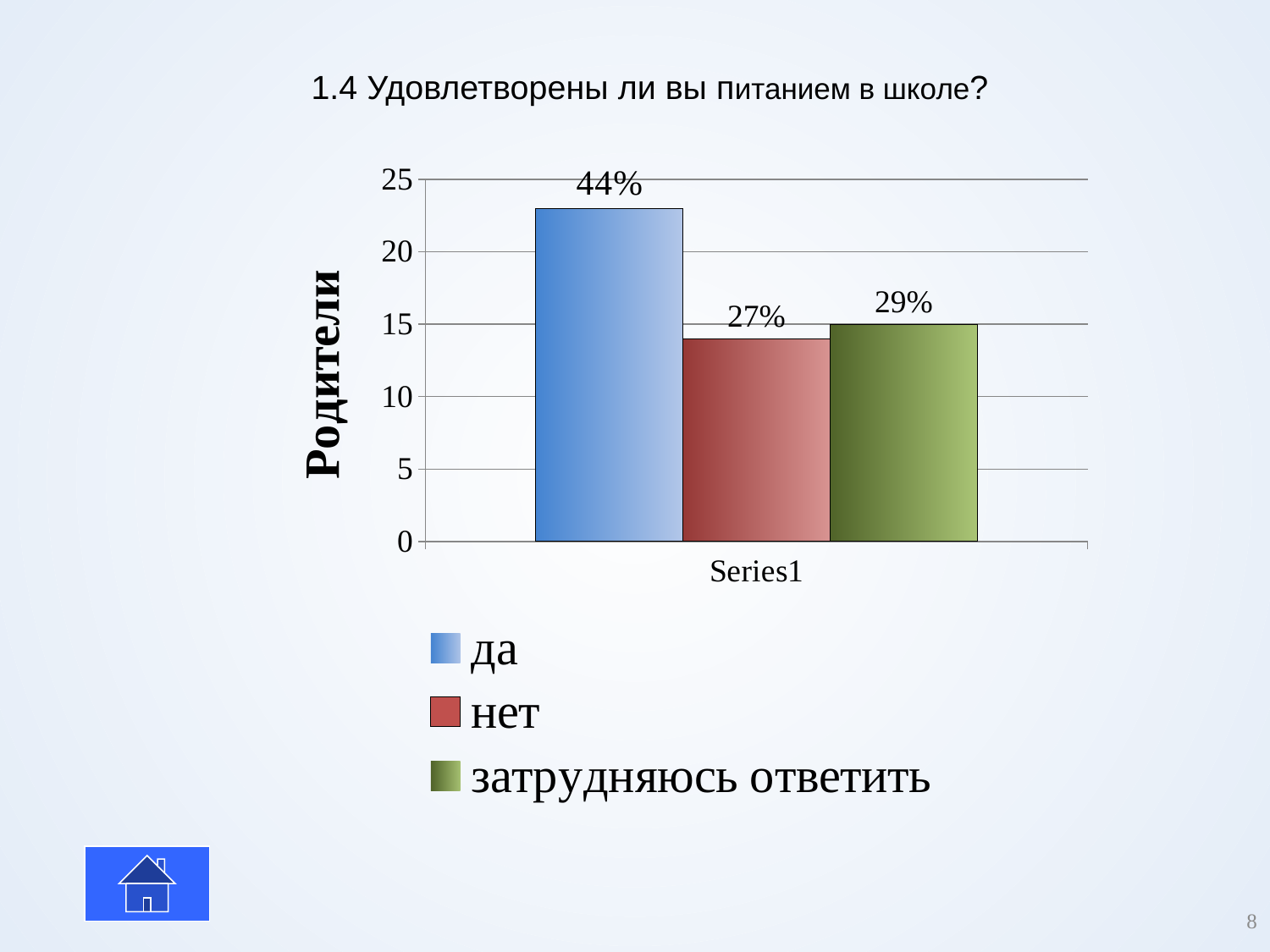
What is the data label on the bar for "да"? 44% Which response has the highest bar? да What is the title of the vertical axis? Родители Is the bar for "нет" greater or less than 15 on the vertical axis? less Which response has the lowest bar? нет What is the data label on the bar for "затрудняюсь ответить"? 29% What type of chart is shown on the slide? bar chart Is the bar for "да" greater or less than 20 on the vertical axis? greater What is the difference between the data labels for "да" and "нет"? 17% How many bars are plotted in the chart? 3 Which has the larger data label, "нет" or "затрудняюсь ответить"? затрудняюсь ответить What is the data label on the bar for "нет"? 27%